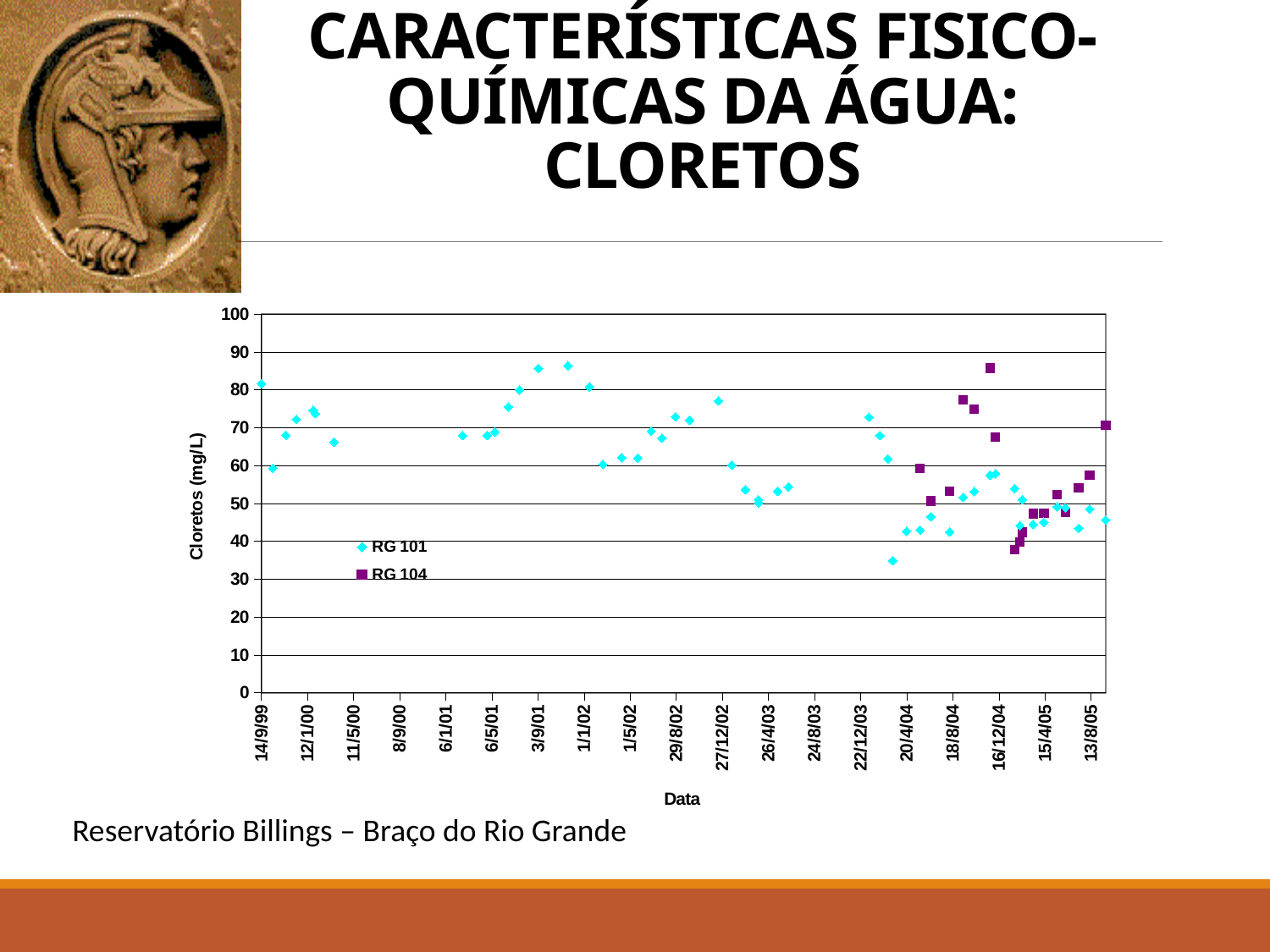
Which is larger for RG 101: the first value at 14/9/99 or the last value at 13/8/05? the first value at 14/9/99 Is the first RG 101 value, at 14/9/99, greater or less than 80? greater Is the last RG 104 value, at 13/8/05, greater or less than 60? greater At 13/8/05, which series has the larger value, RG 101 or RG 104? RG 104 What are the two series named in the legend? RG 101 and RG 104 What is the title of the vertical axis? Cloretos (mg/L) Is the lowest RG 104 value, plotted just after 16/12/04, greater or less than 50? less How many series does the legend list? 2 Overall, do the RG 101 values rise or fall from 1999 to 2005? fall What kind of chart is shown on the slide? scatter chart